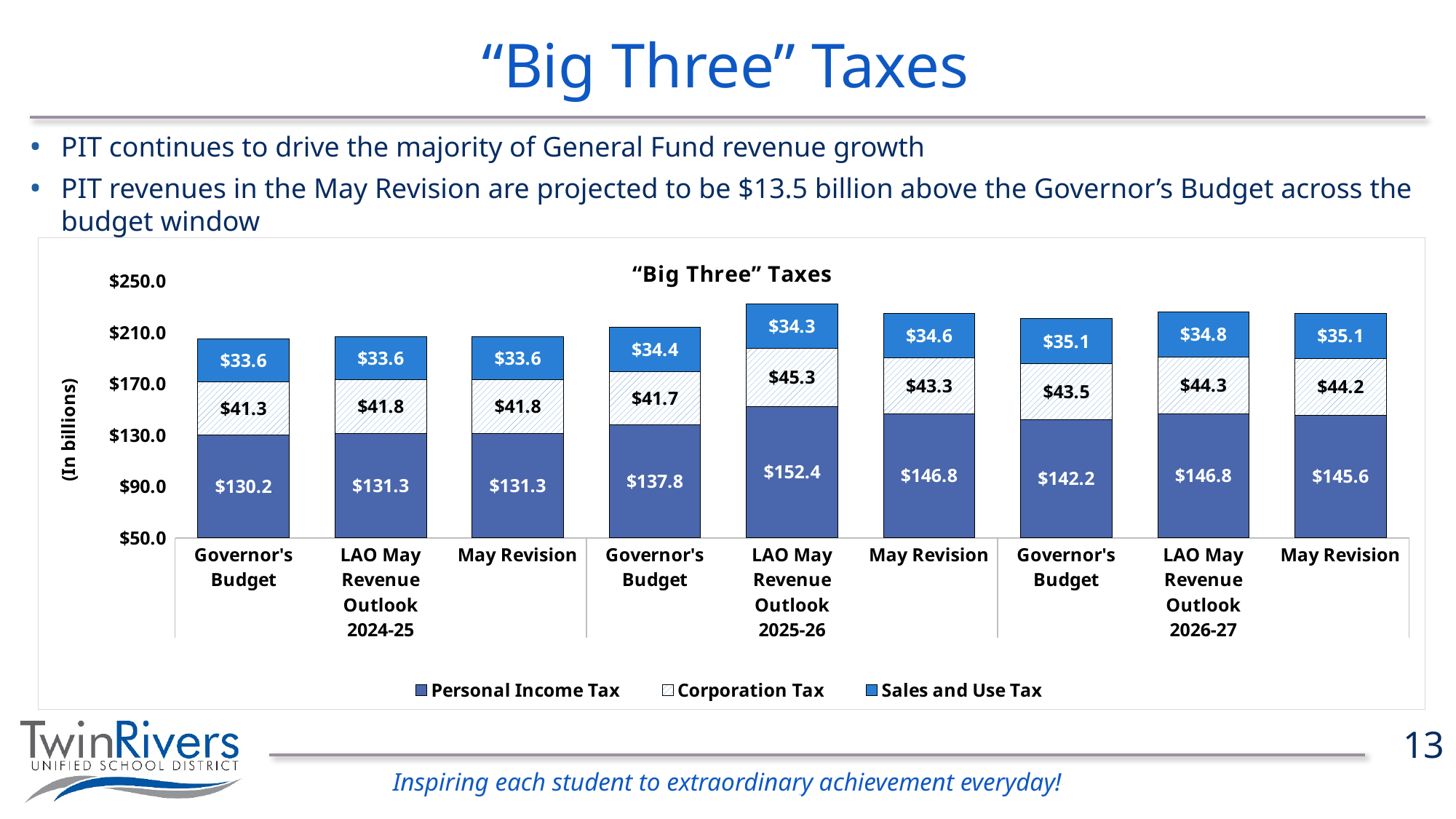
What type of chart is shown on the slide? Stacked bar chart What is the Sales and Use Tax value for the May Revision in 2026-27? $35.1 How many series does the chart legend list? 3 Which is larger: the Corporation Tax value for the Governor's Budget in 2026-27 or for the May Revision in 2026-27? May Revision 2026-27 Which bar has the highest Personal Income Tax value? LAO May Revenue Outlook 2025-26 What unit is shown on the vertical axis label of the chart? In billions What is the Personal Income Tax value for the Governor's Budget in 2024-25? $130.2 What is the Corporation Tax value for the LAO May Revenue Outlook in 2025-26? $45.3 Which bar has the lowest Personal Income Tax value? Governor's Budget 2024-25 What is the total of the stacked bar for the LAO May Revenue Outlook in 2025-26? $232.0 How many stacked bars are plotted in the chart? 9 What is the difference between the Personal Income Tax values for the LAO May Revenue Outlook and the Governor's Budget in 2025-26? $14.6